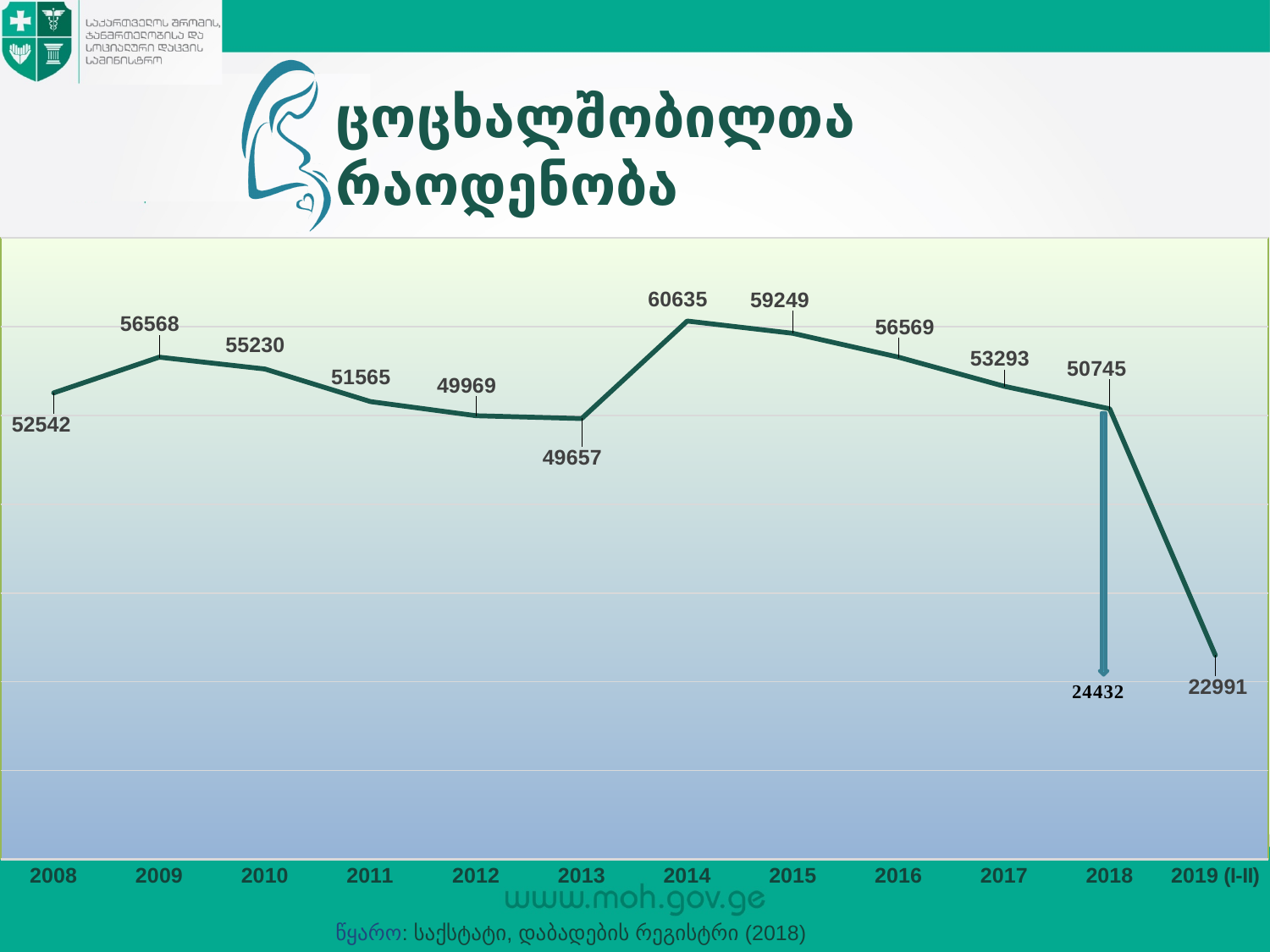
Which is larger, the value for 2010 or the value for 2017? 2010 What is the value for 2008? 52542 What kind of chart is shown on the slide? line chart Which category has the lowest value? 2019 (I-II) What is the value for 2013? 49657 What is the value for 2019 (I-II)? 22991 What is the difference between the values for 2009 and 2008? 4026 What is the value for 2014? 60635 How many data points are plotted on the line? 12 What is the difference between the values for 2014 and 2015? 1386 Which year has the highest value? 2014 Do the values rise or fall from 2014 to 2019 (I-II)? fall